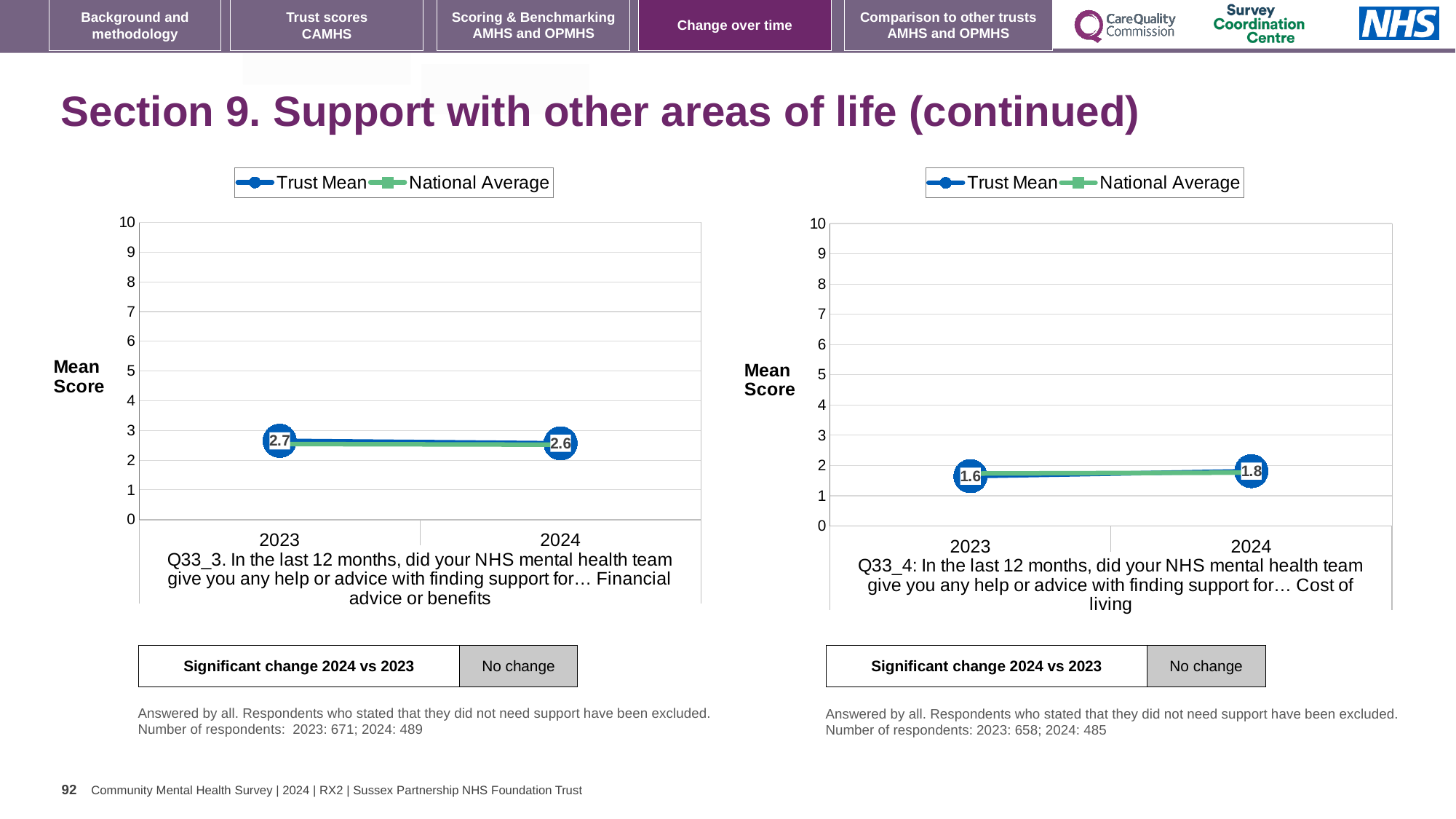
In the right chart (Q33_4, Cost of living), what is the Trust Mean for 2023? 1.6 In the left chart (Q33_3, Financial advice or benefits), does the Trust Mean rise or fall from 2023 to 2024? fall In the right chart (Q33_4, Cost of living), what is the Trust Mean for 2024? 1.8 In the left chart (Q33_3, Financial advice or benefits), is the Trust Mean for 2023 greater or less than 3? less What type of chart is the right chart (Q33_4, Cost of living)? line chart How many series does the legend of the right chart (Q33_4, Cost of living) list? 2 How many years are plotted on the x axis of the left chart (Q33_3, Financial advice or benefits)? 2 In the right chart (Q33_4, Cost of living), by how much did the Trust Mean change from 2023 to 2024? 0.2 In the right chart (Q33_4, Cost of living), does the Trust Mean rise or fall from 2023 to 2024? rise In the left chart (Q33_3, Financial advice or benefits), what is the difference between the Trust Mean in 2023 and 2024? 0.1 In the left chart (Q33_3, Financial advice or benefits), what is the Trust Mean for 2023? 2.7 In the left chart (Q33_3, Financial advice or benefits), what is the Trust Mean for 2024? 2.6